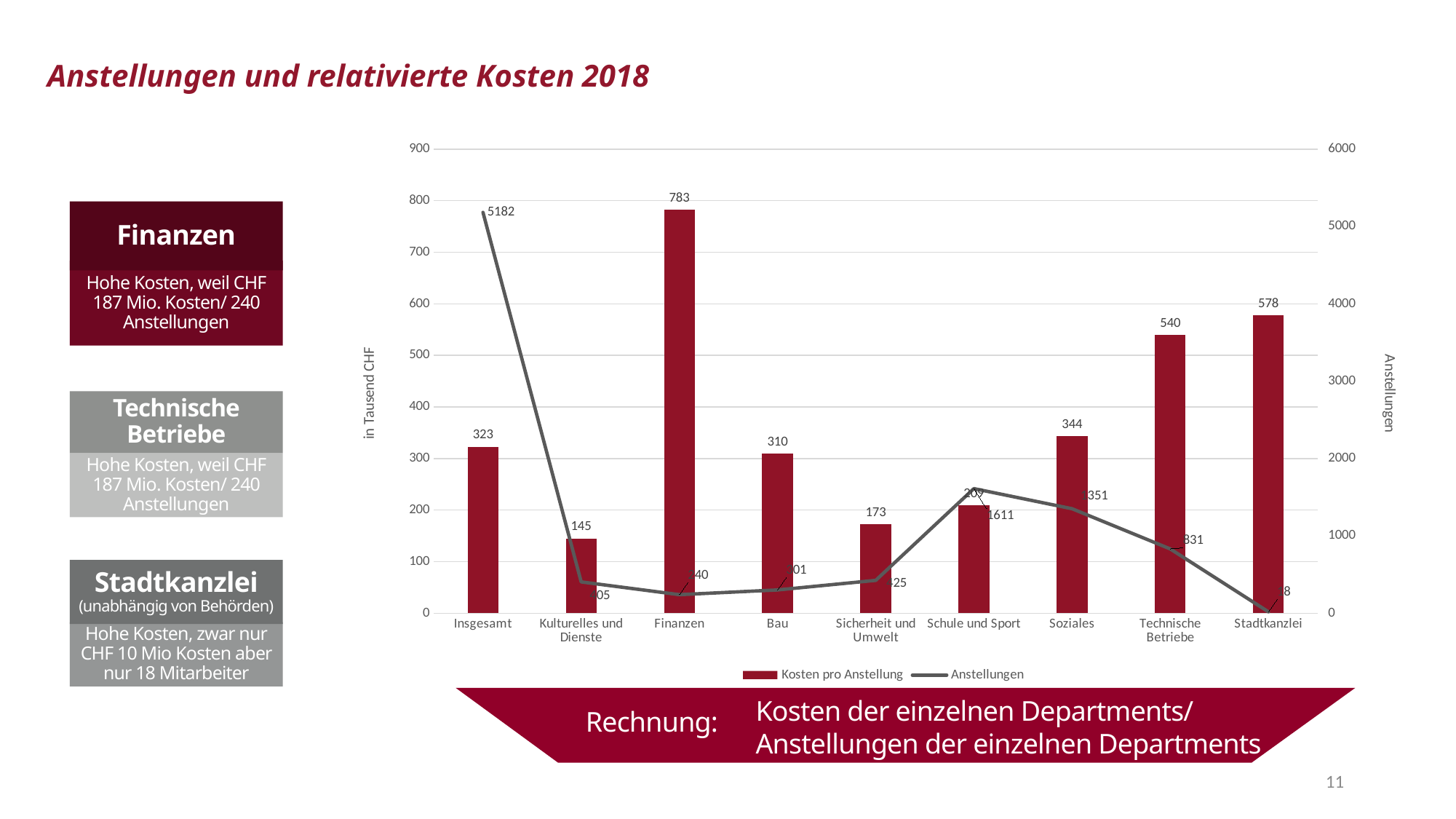
How many Anstellungen are shown for Schule und Sport? 1611 How many series does the legend list? 2 Which category has the highest Kosten pro Anstellung? Finanzen What is the label of the left vertical axis? in Tausend CHF What is the value of Kosten pro Anstellung for Finanzen? 783 Which has higher Kosten pro Anstellung, Soziales or Bau? Soziales How many Anstellungen are shown for Insgesamt? 5182 Is the number of Anstellungen for Kulturelles und Dienste greater or less than 1000? less Which category has the lowest Kosten pro Anstellung? Kulturelles und Dienste What is the value of Kosten pro Anstellung for Stadtkanzlei? 578 How many categories are shown on the x axis? 9 What is the difference in Kosten pro Anstellung between Finanzen and Stadtkanzlei? 205